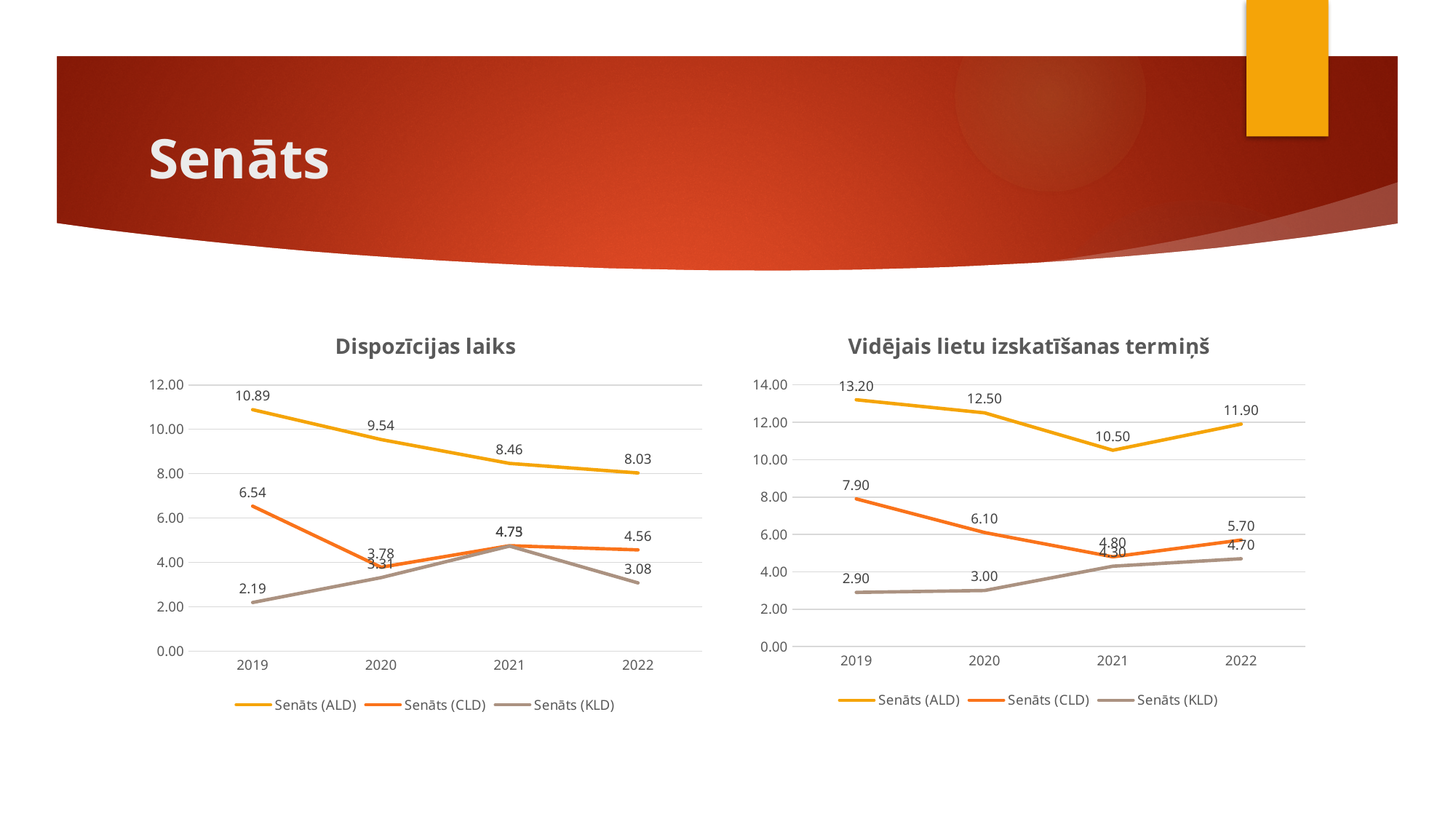
In the 'Dispozīcijas laiks' chart, does the Senāts (ALD) line rise or fall from 2019 to 2022? fall In the 'Dispozīcijas laiks' chart, what is the value for Senāts (KLD) in 2022? 3.08 In the 'Vidējais lietu izskatīšanas termiņš' chart, which is larger in 2022: Senāts (CLD) or Senāts (KLD)? Senāts (CLD) How many series does the legend of the 'Vidējais lietu izskatīšanas termiņš' chart list? 3 In the 'Dispozīcijas laiks' chart, what is the value for Senāts (CLD) in 2020? 3.78 In the 'Vidējais lietu izskatīšanas termiņš' chart, what is the value for Senāts (ALD) in 2021? 10.50 In the 'Vidējais lietu izskatīšanas termiņš' chart, which year has the lowest value for Senāts (CLD)? 2021 In the 'Dispozīcijas laiks' chart, what is the difference between the Senāts (ALD) values in 2019 and 2022? 2.86 In the 'Dispozīcijas laiks' chart, what is the value for Senāts (ALD) in 2019? 10.89 In the 'Vidējais lietu izskatīšanas termiņš' chart, what is the difference between the Senāts (CLD) values in 2019 and 2020? 1.80 In the 'Vidējais lietu izskatīšanas termiņš' chart, what is the value for Senāts (KLD) in 2019? 2.90 In the 'Dispozīcijas laiks' chart, which year has the highest value for Senāts (ALD)? 2019